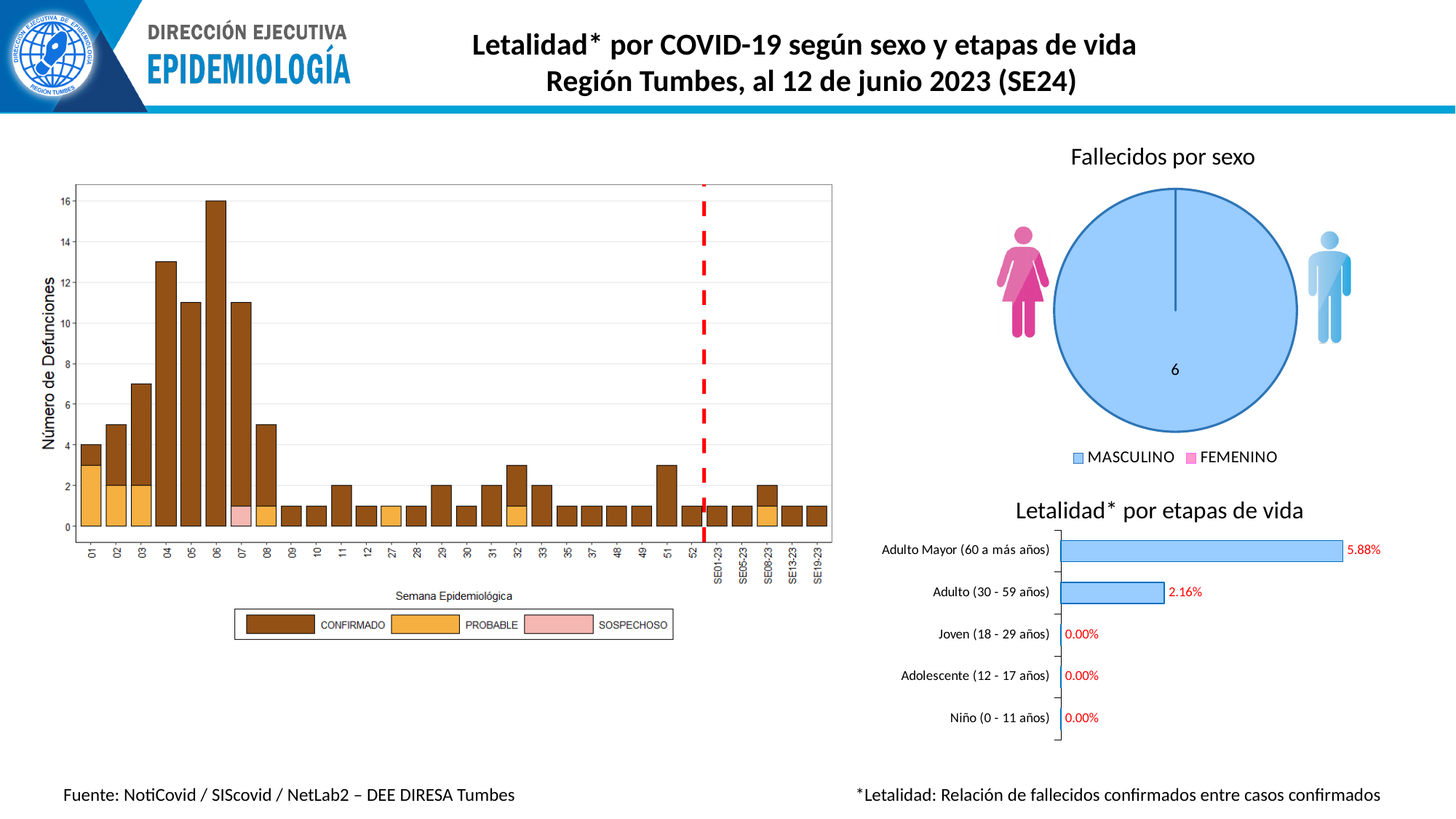
In the 'Letalidad* por etapas de vida' chart, what is the value for Adulto Mayor (60 a más años)? 5.88% In the left chart of deaths by epidemiological week, how many series does the legend list? 3 In the 'Letalidad* por etapas de vida' chart, what is the value for Adulto (30 - 59 años)? 2.16% What kind of chart is 'Letalidad* por etapas de vida'? Bar chart In the 'Fallecidos por sexo' chart, what value is shown for MASCULINO? 6 In the 'Letalidad* por etapas de vida' chart, which age group has the highest value? Adulto Mayor (60 a más años) How many age groups are shown in the 'Letalidad* por etapas de vida' chart? 5 In the left chart of deaths by epidemiological week, is the total value for week 06 greater or less than 14? greater In the 'Letalidad* por etapas de vida' chart, what is the difference between the values for Adulto Mayor (60 a más años) and Adulto (30 - 59 años)? 3.72% What kind of chart is 'Fallecidos por sexo'? Pie chart How many series does the legend of the 'Fallecidos por sexo' chart list? 2 In the 'Letalidad* por etapas de vida' chart, what is the value for Joven (18 - 29 años)? 0.00%